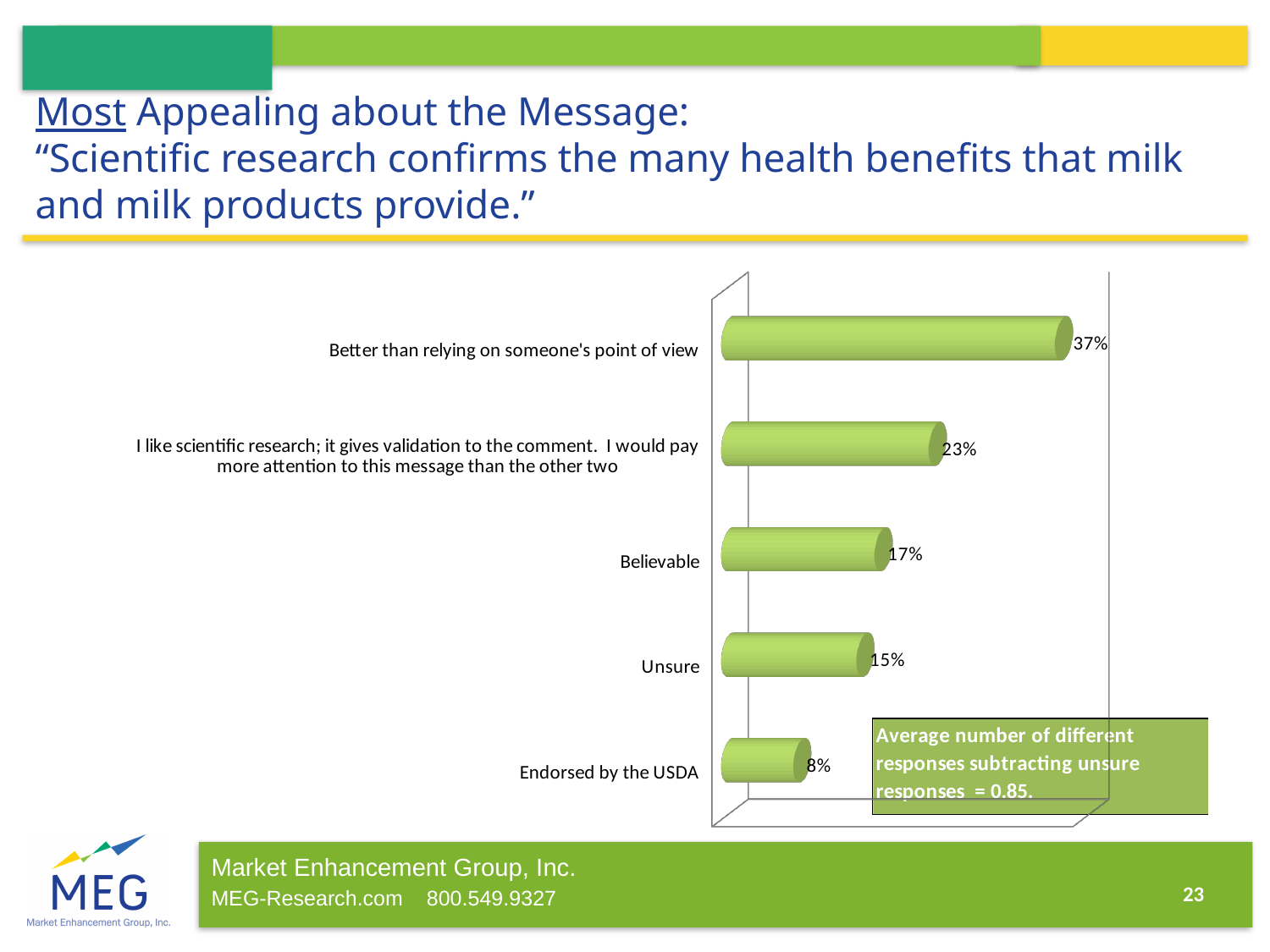
What is the value for "Believable"? 17% What kind of chart is shown on the slide? Bar chart Which is larger: the value for "I like scientific research; it gives validation to the comment. I would pay more attention to this message than the other two" or the value for "Believable"? I like scientific research; it gives validation to the comment. I would pay more attention to this message than the other two Which category has the lowest value? Endorsed by the USDA What percentage of respondents said "Better than relying on someone's point of view"? 37% How many categories are shown in the chart? 5 What is the difference between the values for "Believable" and "Unsure"? 2% What is the value for "Endorsed by the USDA"? 8% According to the text box on the chart, what is the average number of different responses subtracting unsure responses? 0.85 What percentage of respondents were "Unsure"? 15% Which category has the highest value? Better than relying on someone's point of view What is the difference between the values for "Better than relying on someone's point of view" and "Endorsed by the USDA"? 29%